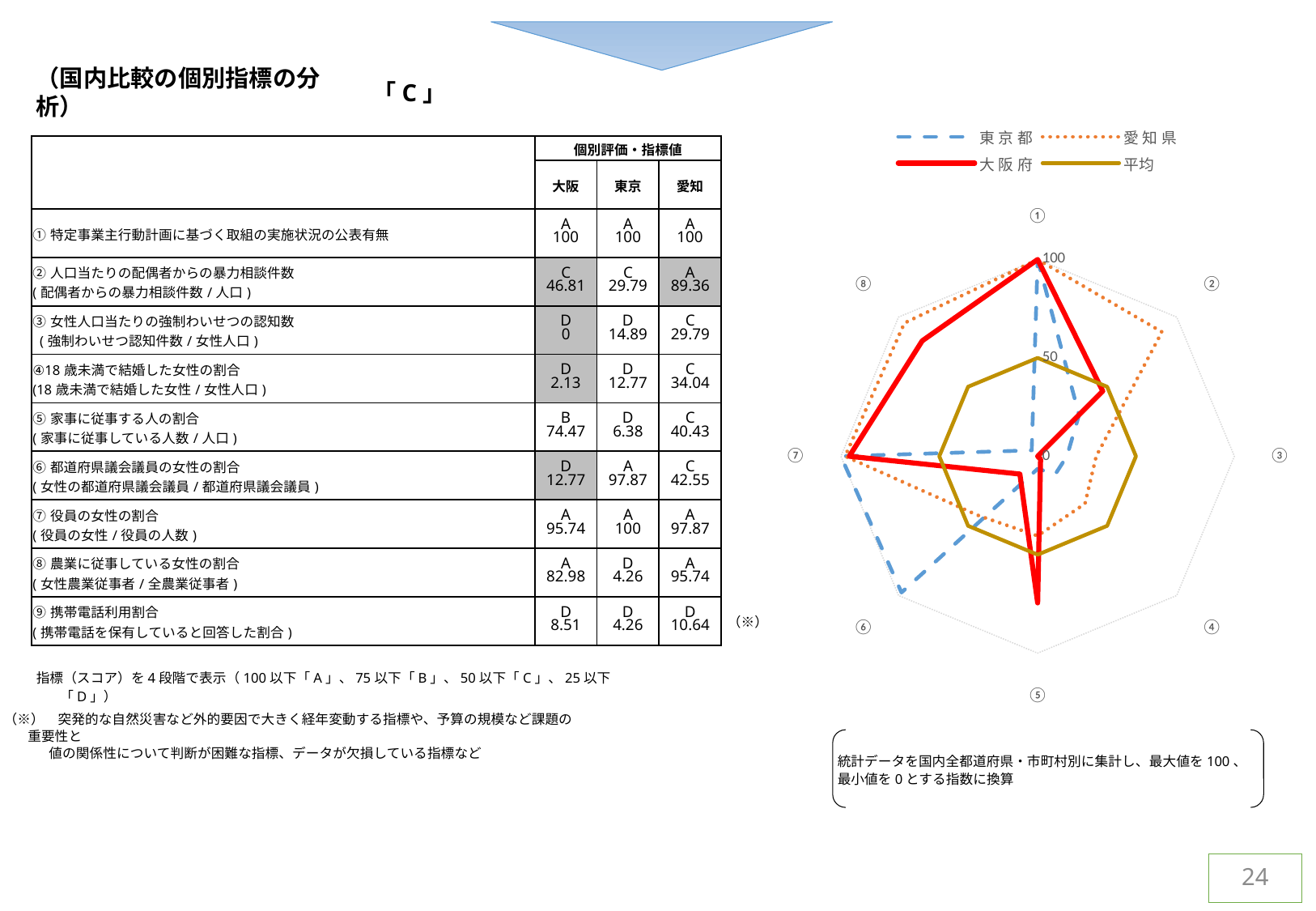
Which series in the radar chart is drawn with a solid red line? 大阪府 How many axes (categories) does the radar chart have? 8 How many series does the legend of the radar chart list? 4 What kind of chart is shown on the right of the slide? radar chart What is the value for 大阪府 on axis ② of the radar chart? 46.81 What is the value for 東京都 on axis ⑥ of the radar chart? 97.87 Is the value for 東京都 on axis ⑧ of the radar chart greater or less than 50? less Which series has the highest value on axis ⑤ of the radar chart? 大阪府 What is the maximum value shown on the radar chart's axis scale? 100 What is the difference between 愛知県 and 東京都 on axis ② of the radar chart? 59.57 Which series has the lowest value on axis ③ of the radar chart? 大阪府 On axis ② of the radar chart, which is larger, 愛知県 or 東京都? 愛知県